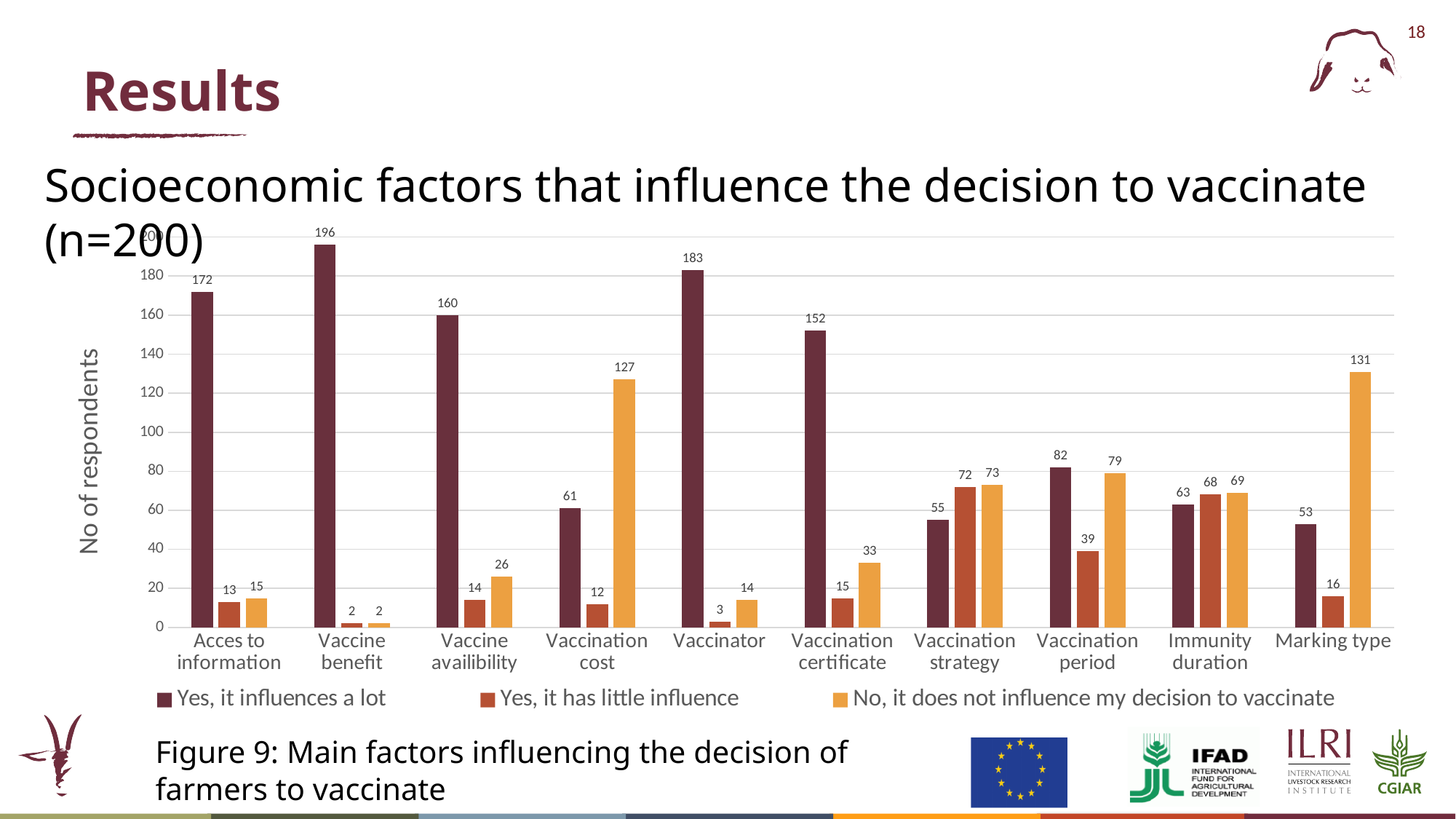
What is the difference between the "Yes, it influences a lot" values for Vaccinator and Vaccination certificate? 31 Which category has the lowest value for "Yes, it influences a lot"? Marking type Which category has the highest value for "No, it does not influence my decision to vaccinate"? Marking type What is the value for "No, it does not influence my decision to vaccinate" for Vaccination cost? 127 What is the value for "Yes, it has little influence" for Vaccination period? 39 Which is larger: the "Yes, it influences a lot" value for Acces to information or for Vaccine availibility? Acces to information What kind of chart is shown on the slide? Bar chart How many categories are shown on the x axis? 10 What is the y-axis label of the chart? No of respondents Which category has the highest value for "Yes, it influences a lot"? Vaccine benefit What is the value for "Yes, it influences a lot" for Vaccine benefit? 196 How many series does the legend list? 3